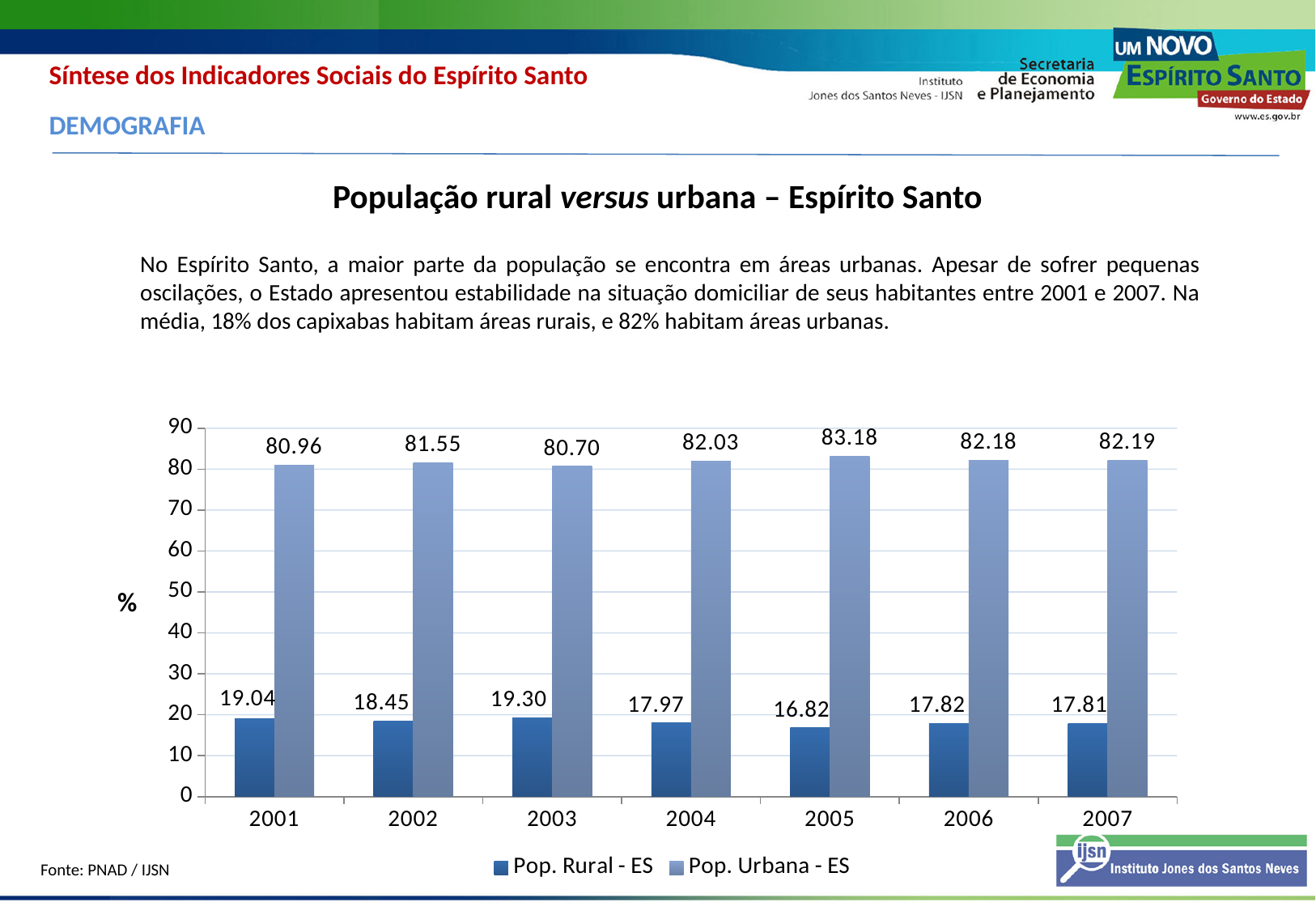
In which year is Pop. Urbana - ES highest? 2005 Which is larger, Pop. Rural - ES in 2001 or Pop. Rural - ES in 2002? Pop. Rural - ES in 2001 How many series does the legend list? 2 In which year is Pop. Rural - ES lowest? 2005 What is the value for Pop. Urbana - ES in 2005? 83.18 What is the difference between Pop. Urbana - ES and Pop. Rural - ES in 2001? 61.92 What is the value for Pop. Rural - ES in 2003? 19.30 What kind of chart is shown? bar chart What is the label on the vertical axis? % Is the value for Pop. Urbana - ES in 2003 greater or less than 70? greater What is the value for Pop. Rural - ES in 2007? 17.81 How many years are shown on the x axis? 7